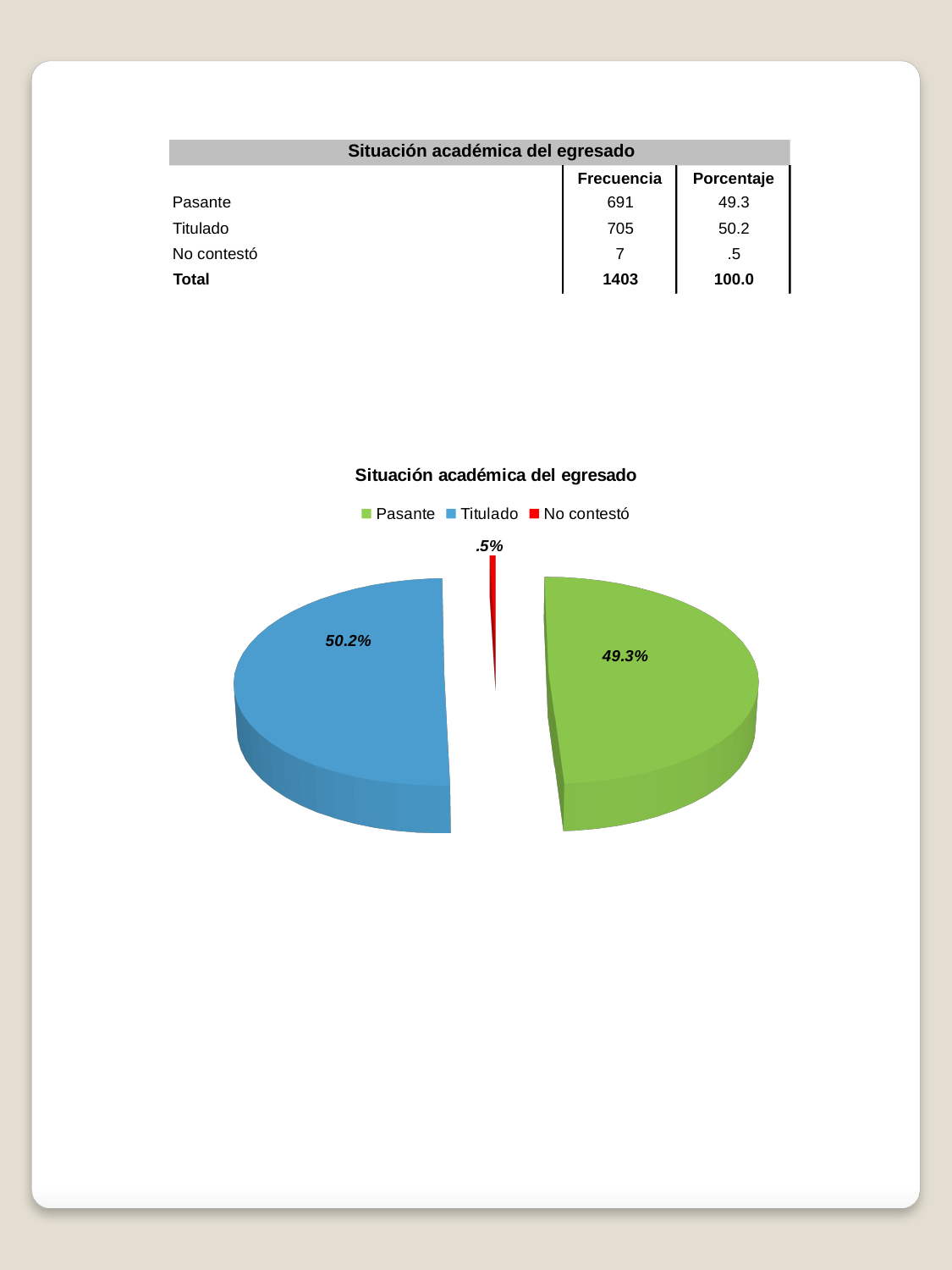
What type of chart is shown on the slide? pie chart Which category has the smallest slice of the pie? No contestó What percentage does the Pasante slice show? 49.3% What colour is the Titulado slice? blue What percentage does the No contestó slice show? .5% What is the title of the chart? Situación académica del egresado What percentage does the Titulado slice show? 50.2% Which is larger, the Pasante slice or the No contestó slice? Pasante What is the difference between the Pasante and No contestó percentages? 48.8% How many categories does the legend list? 3 What is the difference between the Titulado and Pasante percentages? 0.9%